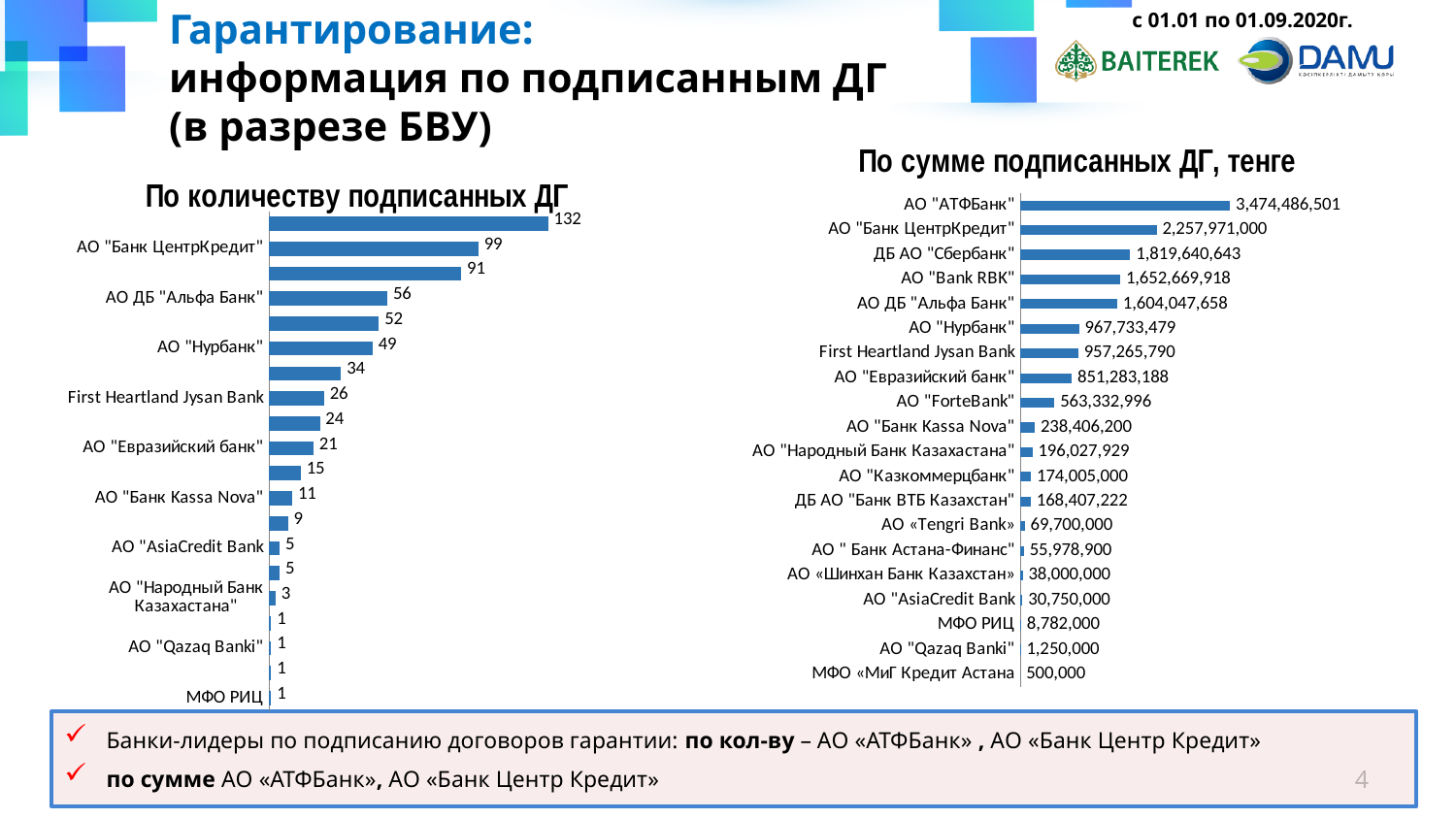
In the chart "По количеству подписанных ДГ", what is the value for АО "Банк ЦентрКредит"? 99 In the chart "По сумме подписанных ДГ, тенге", what is the value for ДБ АО "Сбербанк"? 1,819,640,643 In the chart "По сумме подписанных ДГ, тенге", which is larger: АО "Нурбанк" or First Heartland Jysan Bank? АО "Нурбанк" In the chart "По сумме подписанных ДГ, тенге", what is the difference between АО "АТФБанк" and АО "Банк ЦентрКредит"? 1,216,515,501 In the chart "По сумме подписанных ДГ, тенге", which category has the lowest value? МФО «МиГ Кредит Астана» In the chart "По сумме подписанных ДГ, тенге", what is the value for АО "Qazaq Banki"? 1,250,000 In the chart "По количеству подписанных ДГ", what is the difference between АО "Банк ЦентрКредит" and АО ДБ "Альфа Банк"? 43 In the chart "По количеству подписанных ДГ", what is the value for АО "Нурбанк"? 49 In the chart "По сумме подписанных ДГ, тенге", which bank has the highest value? АО "АТФБанк" What type of chart is "По количеству подписанных ДГ"? Bar chart How many banks are shown in the chart "По сумме подписанных ДГ, тенге"? 20 In the chart "По количеству подписанных ДГ", what is the value for First Heartland Jysan Bank? 26